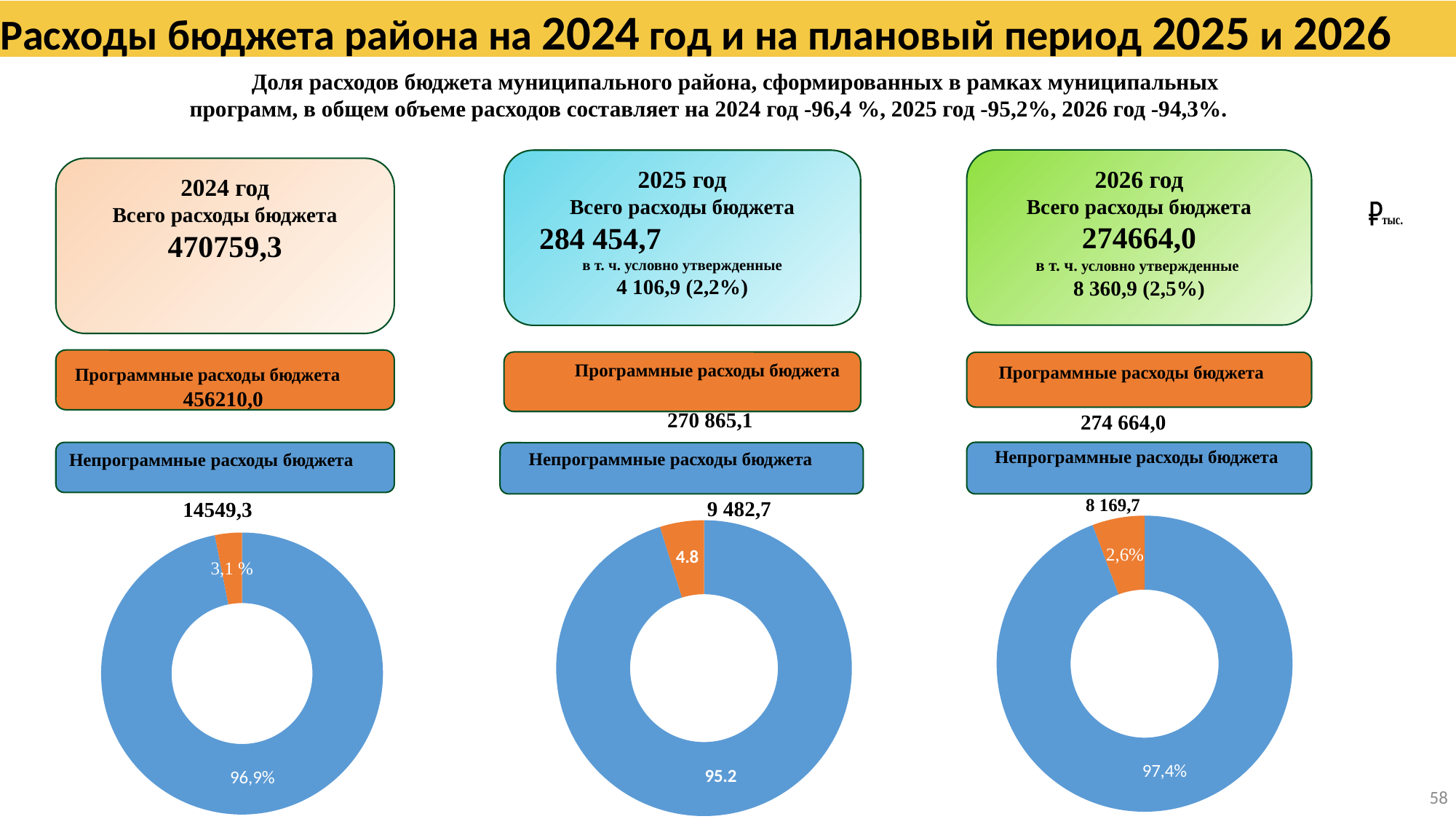
Which is larger: the orange slice in the middle donut chart (2025) or the orange slice in the right donut chart (2026)? The orange slice in the middle chart (2025) In the left donut chart (2024), what share is shown for the blue slice? 96,9% In the right donut chart (2026), what share is shown for the blue slice? 97,4% In the right donut chart (2026), which slice is the largest? The blue slice (97,4%) How many donut charts are shown on the slide? 3 In the middle donut chart (2025), which slice is the smallest? The orange slice (4.8) In the left donut chart (2024), what share is shown for the orange slice? 3,1 % In the middle donut chart (2025), what value is shown on the orange slice? 4.8 In the middle donut chart (2025), what value is shown on the blue slice? 95.2 In the right donut chart (2026), what share is shown for the orange slice? 2,6% How many slices does the left donut chart (2024) have? 2 What kind of chart is the left chart under the 2024 column? Donut (pie) chart